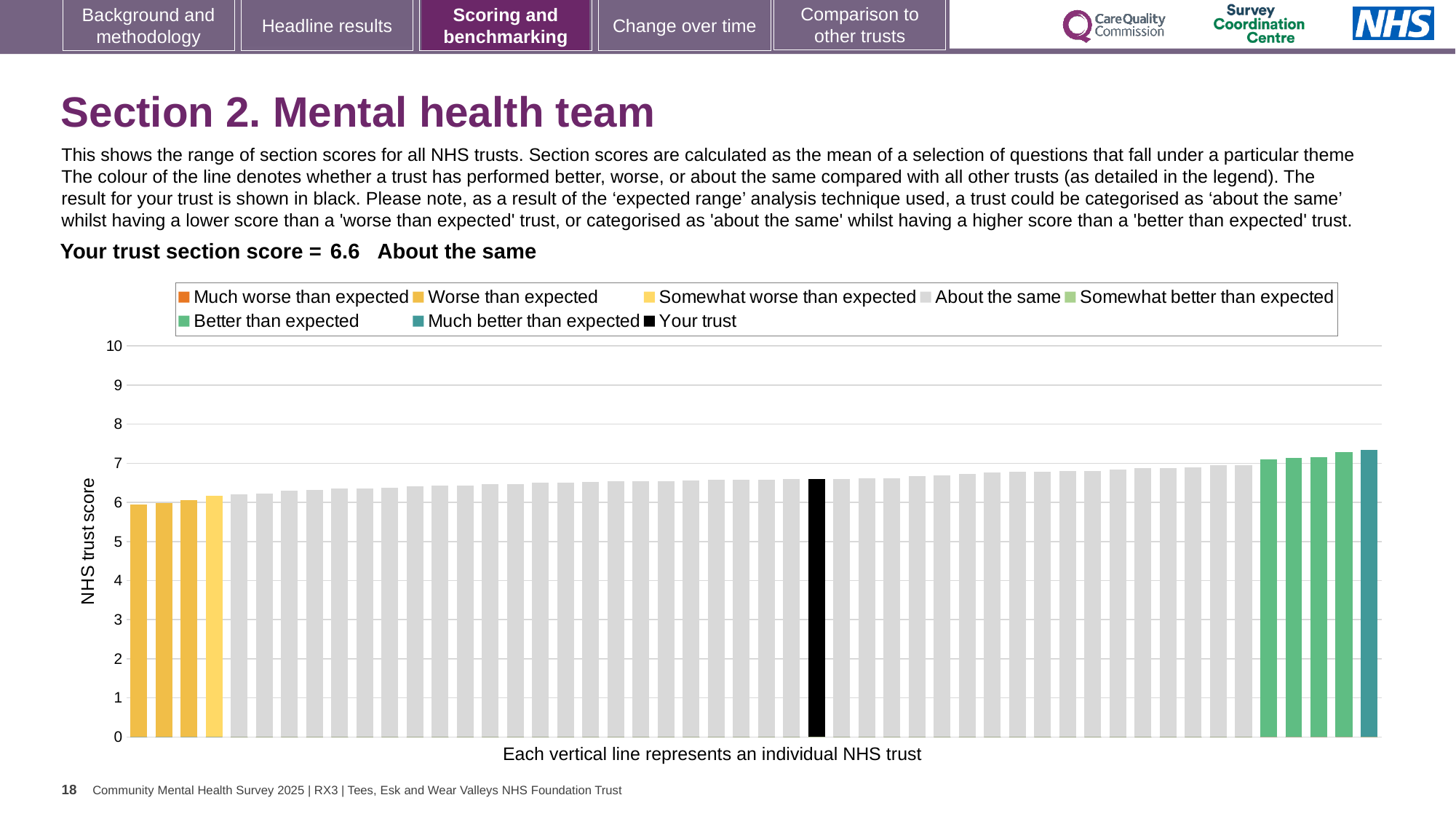
Which performance category is your trust placed in for this section? About the same Is the value of the tallest bar greater or less than 7? greater Do the bar values rise or fall from left to right along the x axis? rise How many categories does the chart legend list? 8 What kind of chart is shown on the slide? bar chart Is the value of the black bar (your trust) greater or less than 6? greater Is the value of the black bar (your trust) greater or less than 7? less What is the section score for your trust shown on the slide? 6.6 What colour is used for the 'Your trust' bar according to the legend? black How many black bars are there in the chart? 1 What is the label on the vertical axis of the chart? NHS trust score